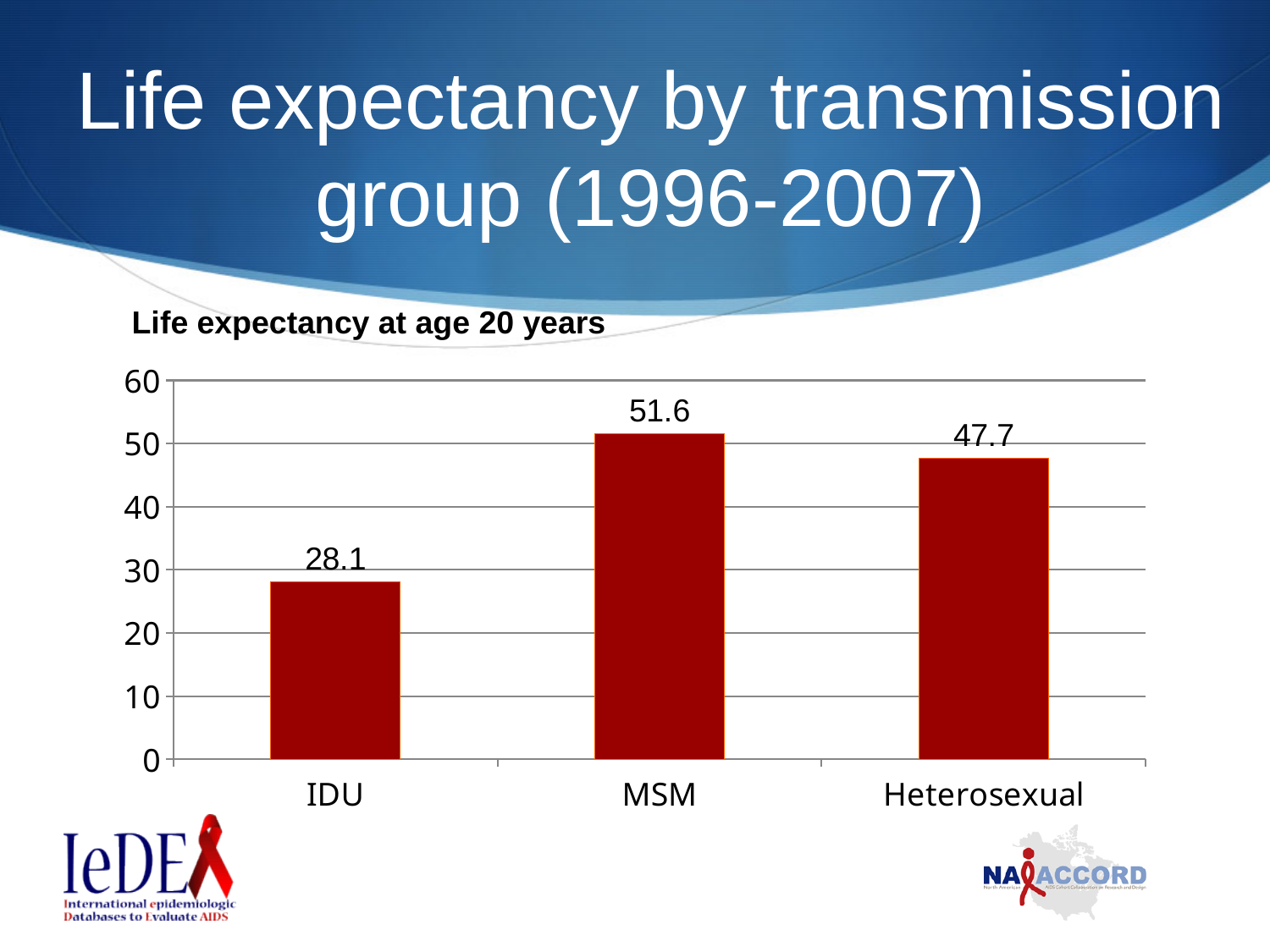
Is the value for IDU greater or less than 30? less Which transmission group has the lowest life expectancy at age 20? IDU What is the difference in life expectancy between the MSM and Heterosexual groups? 3.9 How many transmission groups are shown in the chart? 3 What is the difference in life expectancy between the MSM and IDU groups? 23.5 Which transmission group has the highest life expectancy at age 20? MSM Which group has a higher life expectancy, Heterosexual or IDU? Heterosexual What is the life expectancy at age 20 for the IDU group? 28.1 What is the label above the chart describing the measure plotted? Life expectancy at age 20 years What kind of chart is shown on the slide? bar chart What is the life expectancy at age 20 for the Heterosexual group? 47.7 What is the life expectancy at age 20 for the MSM group? 51.6